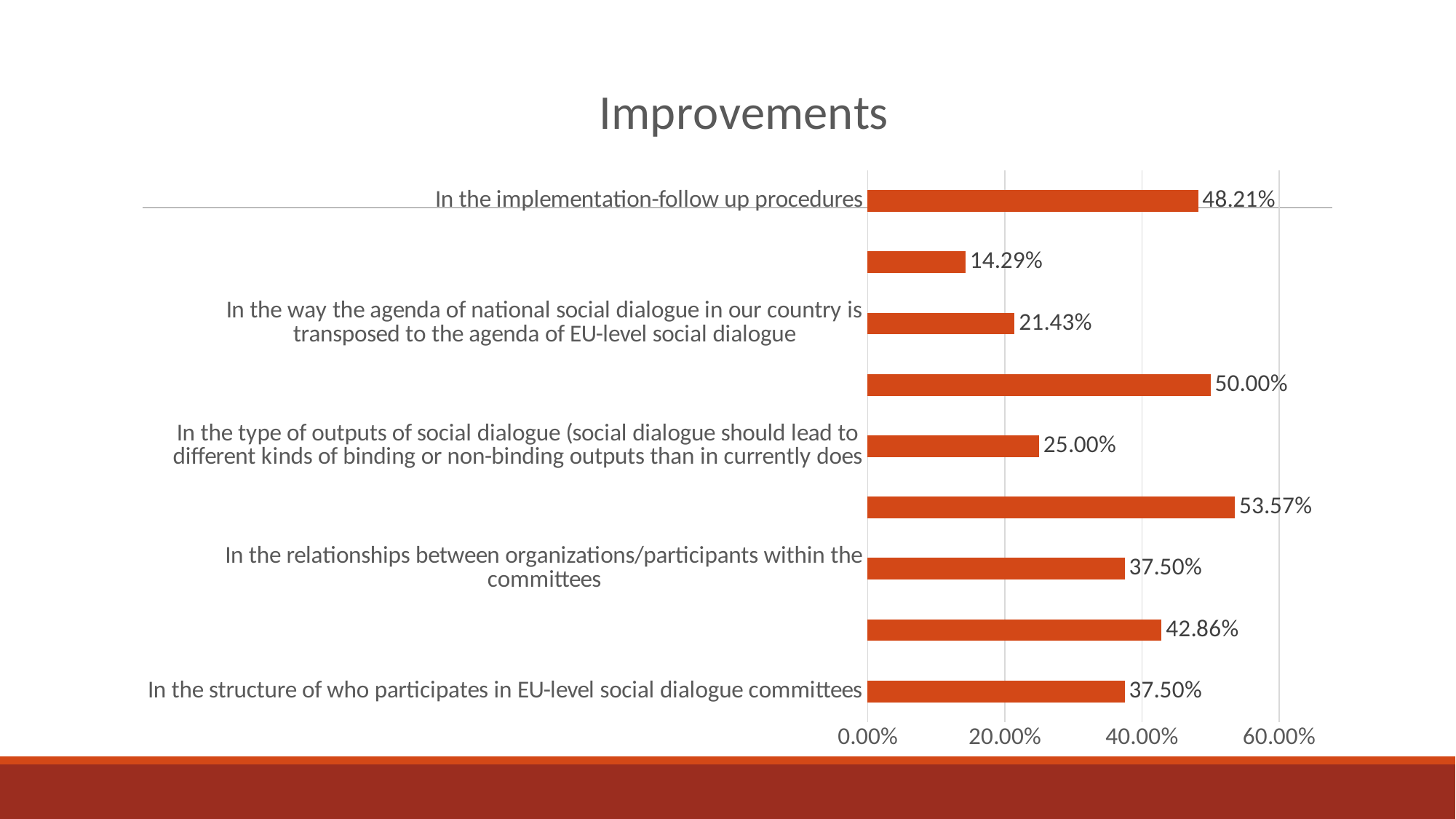
What is the value for 'In the implementation-follow up procedures'? 48.21% What is the lowest value shown by any bar on the chart? 14.29% What is the value for 'In the structure of who participates in EU-level social dialogue committees'? 37.50% What type of chart is shown on the slide? bar chart What is the difference between the values for 'In the implementation-follow up procedures' and 'In the structure of who participates in EU-level social dialogue committees'? 10.71% Is the value for 'In the way the agenda of national social dialogue in our country is transposed to the agenda of EU-level social dialogue' greater or less than 40.00%? less What is the value for 'In the type of outputs of social dialogue'? 25.00% What is the highest value shown by any bar on the chart? 53.57% What is the value for 'In the relationships between organizations/participants within the committees'? 37.50% Which is larger: the value for 'In the implementation-follow up procedures' or the value for 'In the type of outputs of social dialogue'? In the implementation-follow up procedures How many bars are plotted on the chart? 9 What is the value for 'In the way the agenda of national social dialogue in our country is transposed to the agenda of EU-level social dialogue'? 21.43%